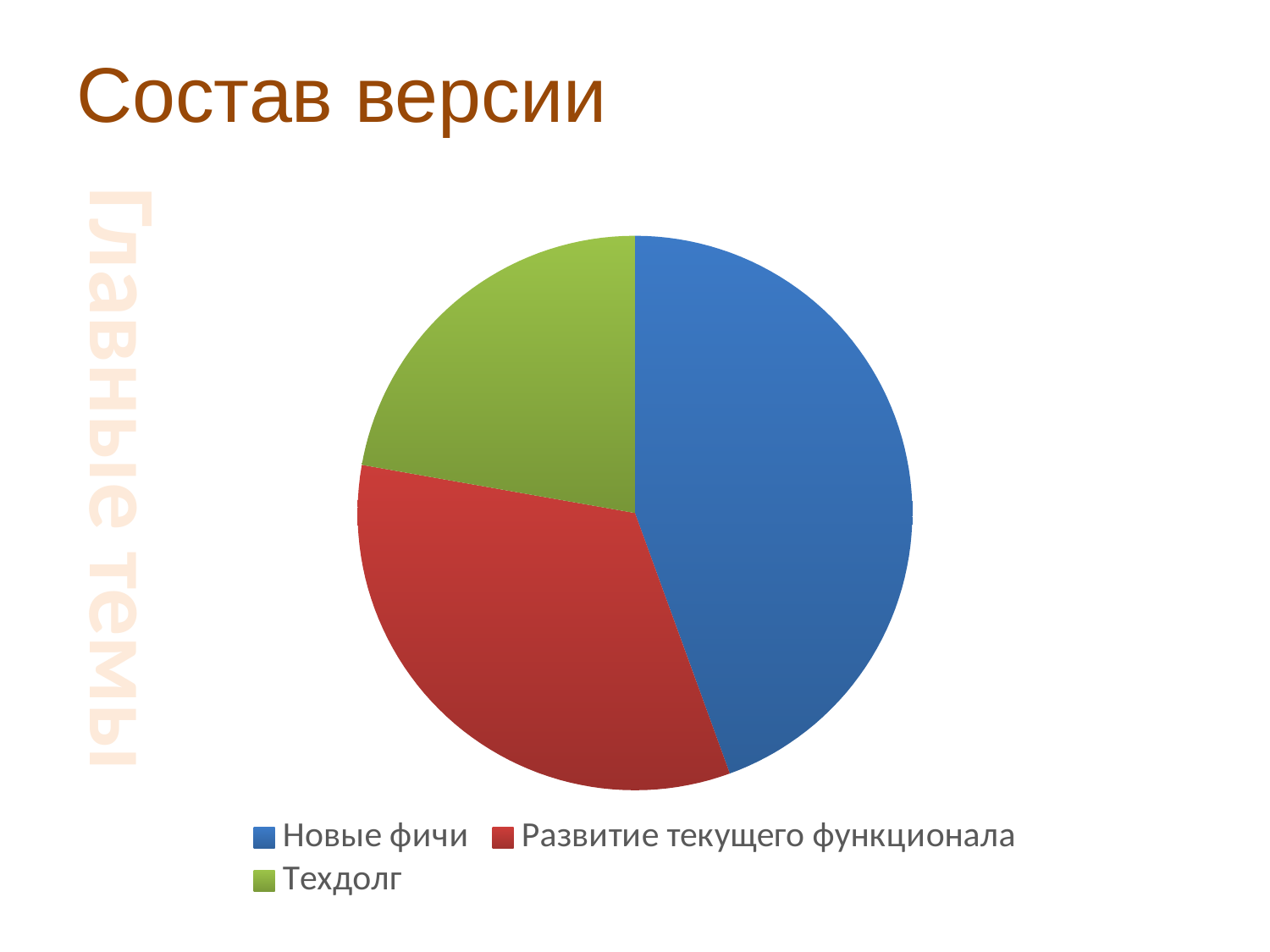
How many entries does the legend of the pie chart list? 3 What kind of chart is shown on the slide? pie chart How many slices does the pie chart have? 3 Which slice is larger: Развитие текущего функционала or Техдолг? Развитие текущего функционала What is the title of the slide containing the pie chart? Состав версии What colour is the slice for Техдолг in the pie chart? green Which slice is larger: Новые фичи or Техдолг? Новые фичи Which category has the smallest slice of the pie chart? Техдолг Which category has the largest slice of the pie chart? Новые фичи Which slice is larger: Новые фичи or Развитие текущего функционала? Новые фичи